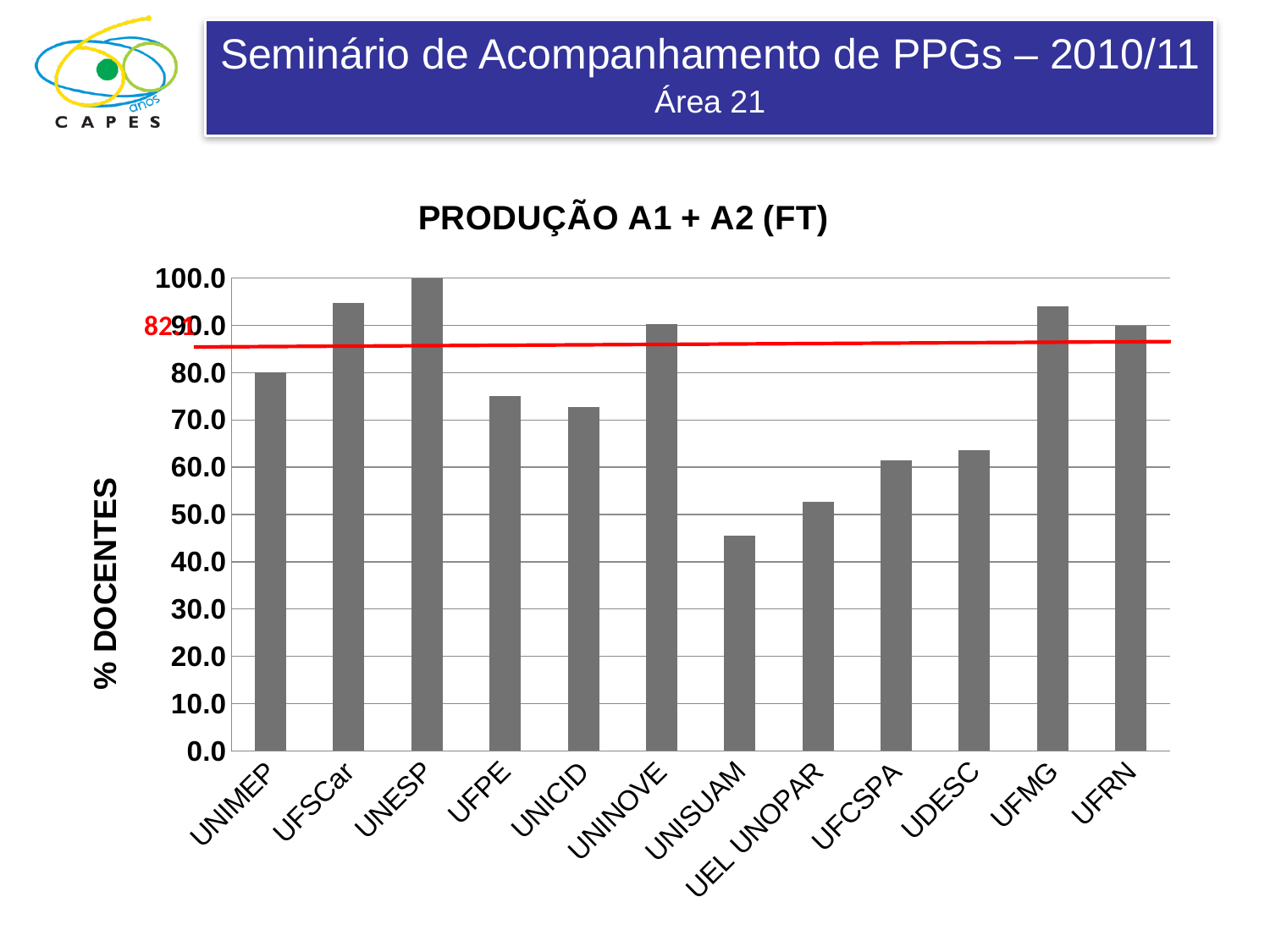
Which institution has the lowest value in the chart? UNISUAM Is the value for UNISUAM greater or less than 50.0? less What is the value for UNESP? 100.0 Is the value for UFSCar greater or less than 90.0? greater Which has a larger value, UNINOVE or UNISUAM? UNINOVE Is the value for UEL UNOPAR greater or less than 50.0? greater What is the title of the chart? PRODUÇÃO A1 + A2 (FT) Which institution has the highest value in the chart? UNESP What kind of chart is shown on the slide? bar chart Which has a larger value, UNIMEP or UFPE? UNIMEP How many institutions are shown on the x axis of the chart? 12